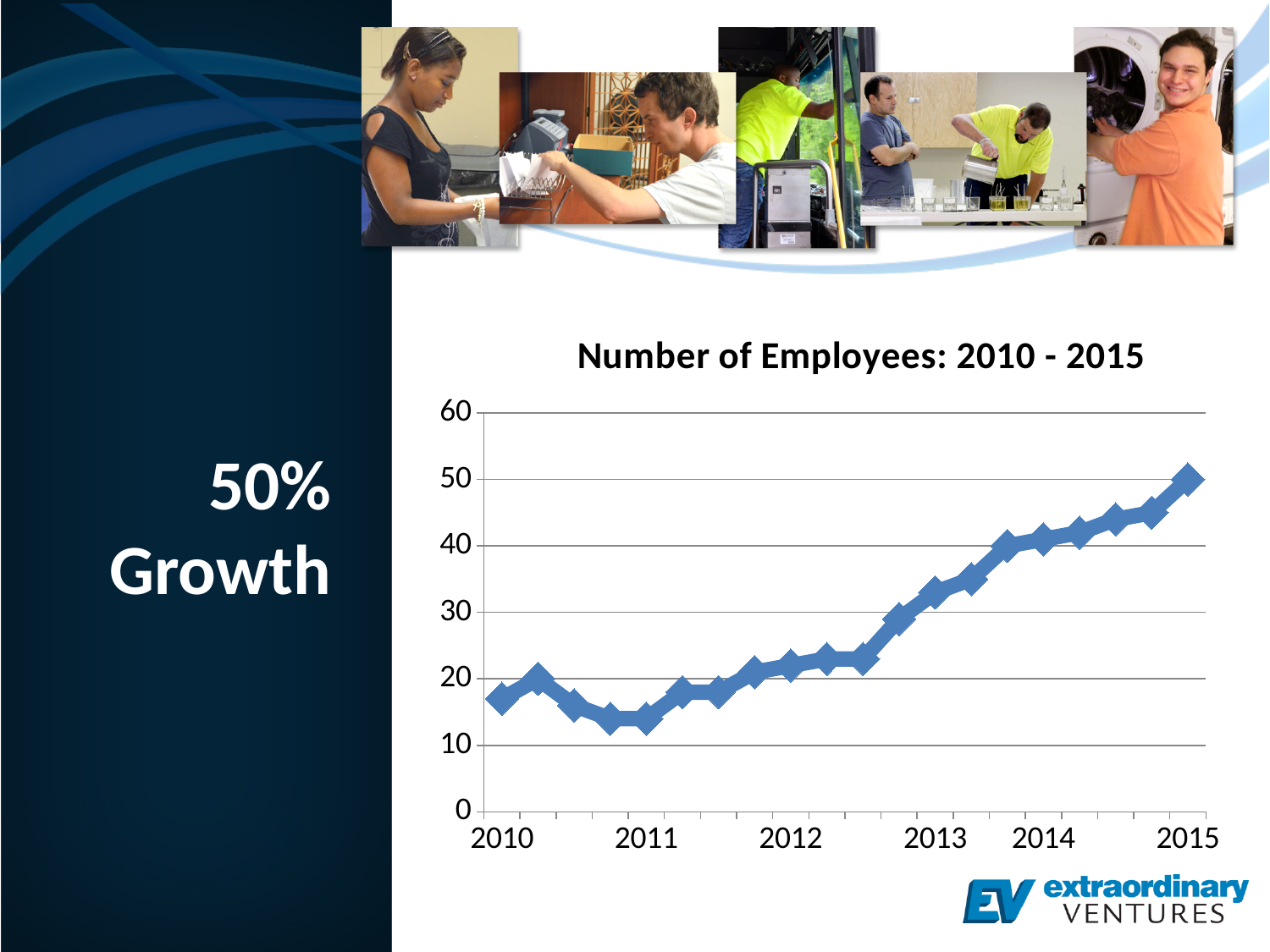
Overall, do the values rise or fall from 2010 to 2015? rise Which labeled year has the highest number of employees? 2015 Is the number of employees in 2012 greater or less than 30? less What is the title of the chart? Number of Employees: 2010 - 2015 Which labeled year has the lowest number of employees? 2011 What kind of chart is shown on the slide? line chart How many year labels are shown on the x axis? 6 Is the number of employees in 2015 greater or less than 40? greater Is the number of employees in 2010 greater or less than 20? less Which year has more employees, 2012 or 2014? 2014 What is the highest value shown on the y axis? 60